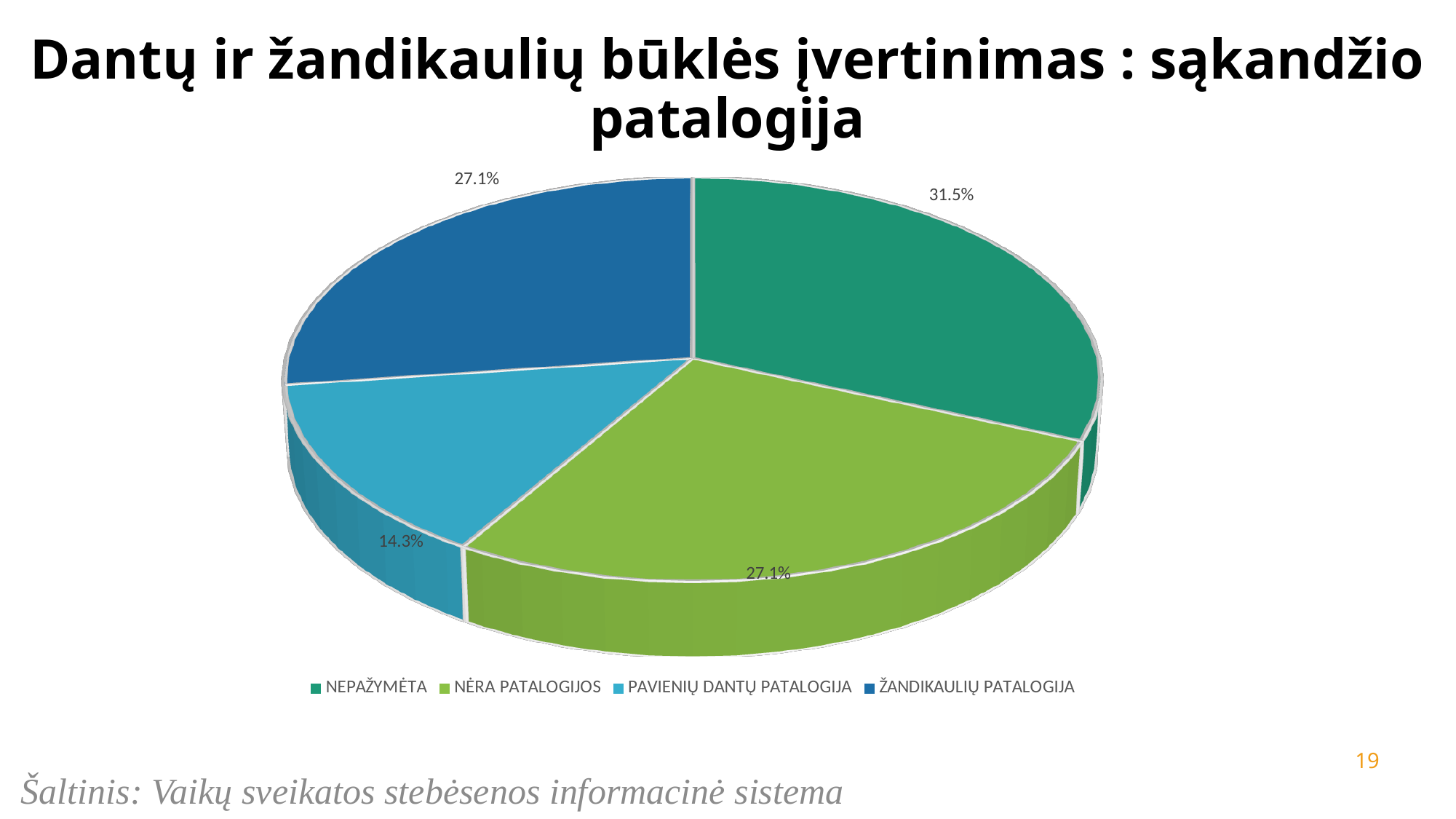
Which category has the largest slice of the pie? NEPAŽYMĖTA What colour is the slice for PAVIENIŲ DANTŲ PATALOGIJA? Light blue What share of the pie does PAVIENIŲ DANTŲ PATALOGIJA represent? 14.3% What kind of chart is shown on the slide? Pie chart What is the difference in percentage points between the NEPAŽYMĖTA slice and the PAVIENIŲ DANTŲ PATALOGIJA slice? 17.2 percentage points What is the difference in percentage points between the NEPAŽYMĖTA slice and the ŽANDIKAULIŲ PATALOGIJA slice? 4.4 percentage points What share of the pie does ŽANDIKAULIŲ PATALOGIJA represent? 27.1% How many slices does the pie chart have? 4 Which is larger: the slice for NEPAŽYMĖTA or the slice for PAVIENIŲ DANTŲ PATALOGIJA? NEPAŽYMĖTA What share of the pie does NĖRA PATALOGIJOS represent? 27.1% What share of the pie does NEPAŽYMĖTA represent? 31.5% Which category has the smallest slice of the pie? PAVIENIŲ DANTŲ PATALOGIJA